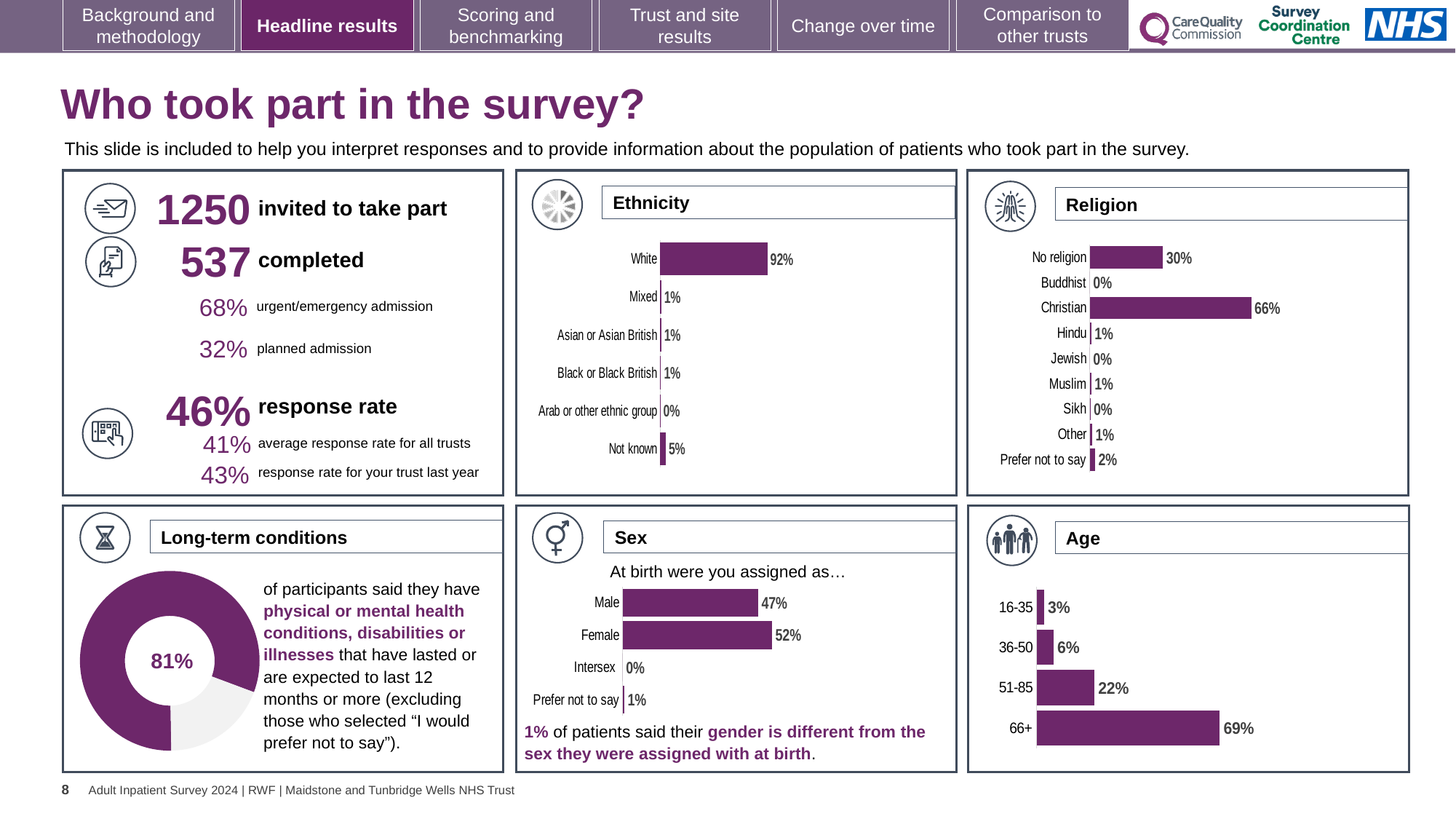
In the Ethnicity chart, what is the value for Not known? 5% In the Religion chart, what is the difference between Christian and No religion? 36% In the Sex chart, what is the value for Prefer not to say? 1% How many categories does the Religion chart show? 9 In the Sex chart, which is larger, Male or Female? Female In the Age chart, what is the value for 51-85? 22% In the Age chart, which age group has the highest value? 66+ What kind of chart is used in the Long-term conditions panel? doughnut chart In the Age chart, do the values rise or fall as the age groups increase? rise In the Religion chart, what percentage of participants are Christian? 66% In the Ethnicity chart, what percentage of participants are White? 92% In the Ethnicity chart, which category has the highest value? White